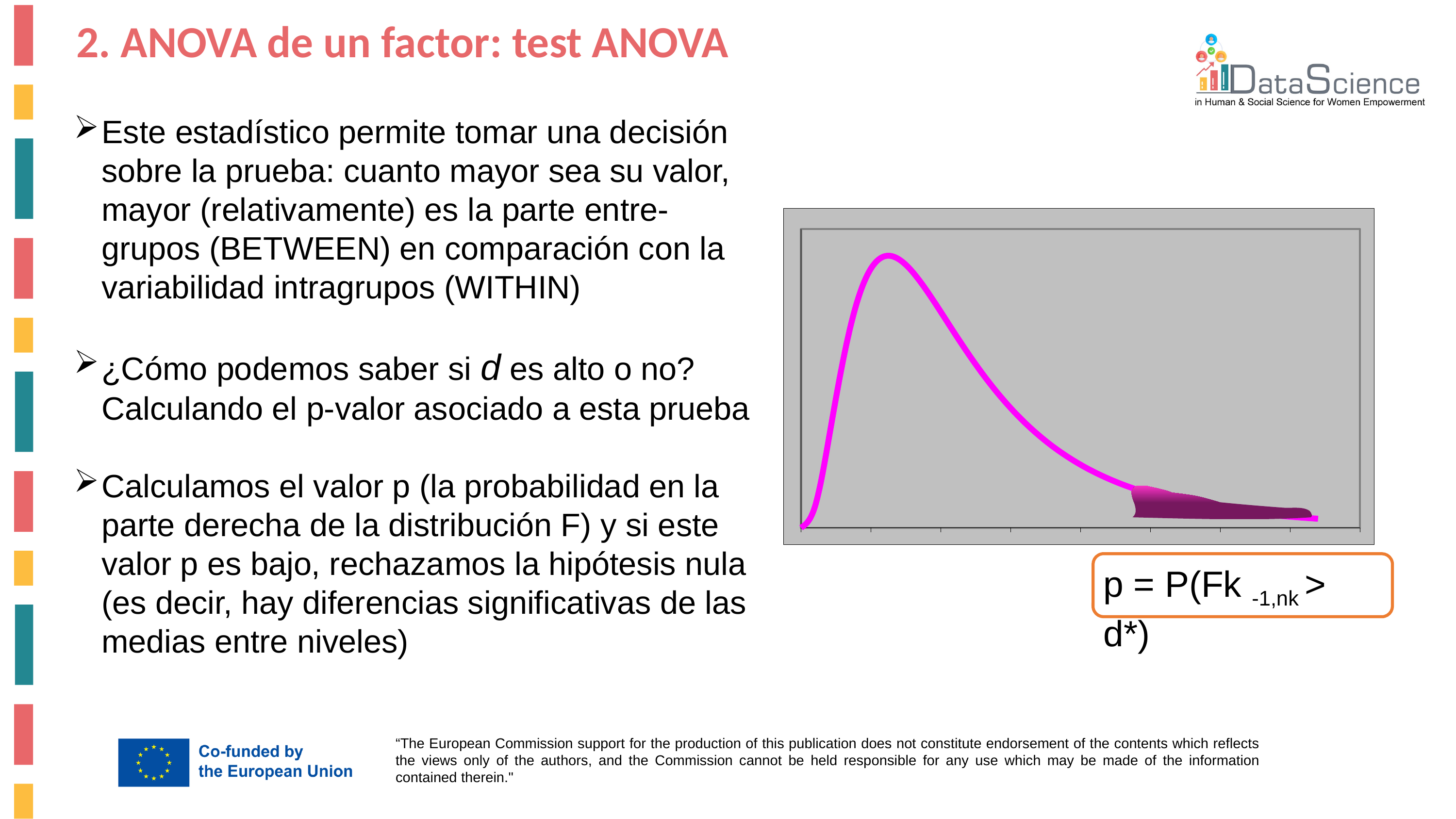
Does the curve rise or fall between the left edge of the chart and its peak? rise Is the peak of the curve located in the left half or the right half of the chart? left half Moving left to right after its peak, does the curve rise or fall? fall What colour is the plotted curve in the chart? magenta What kind of chart is shown on the right of the slide? line chart On which side of the chart is the shaded area under the curve, the left tail or the right tail? right tail How many curves are plotted in the chart? 1